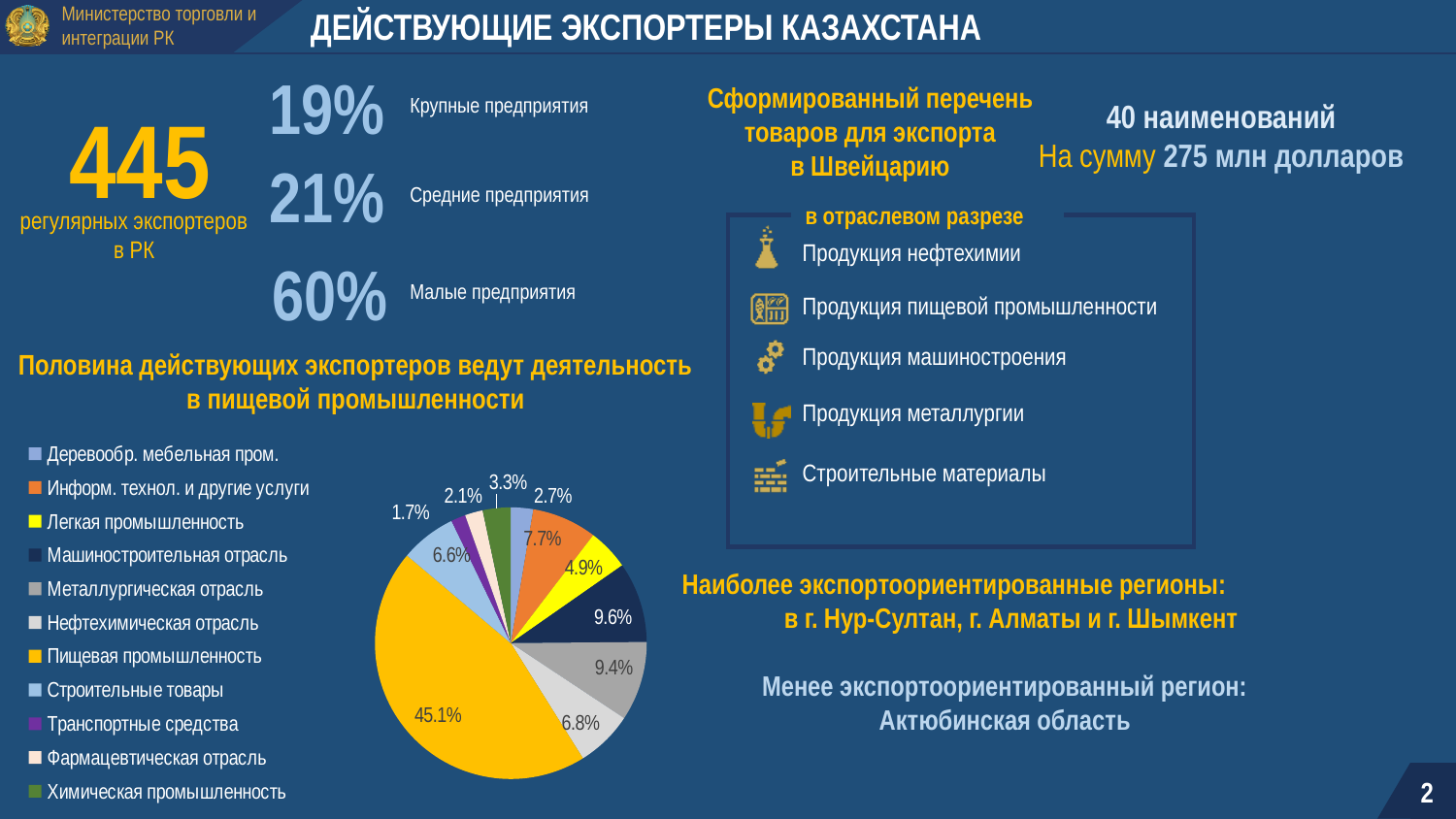
What is the value shown for Химическая промышленность? 3.3% What is the value shown for Машиностроительная отрасль? 9.6% Which category has the largest slice of the pie chart? Пищевая промышленность What kind of chart is shown on the slide? pie chart What is the value shown for Информ. технол. и другие услуги? 7.7% How many categories does the pie chart's legend list? 11 What is the value shown for Нефтехимическая отрасль? 6.8% Which is larger, the share of Строительные товары or the share of Легкая промышленность? Строительные товары Which colour represents Пищевая промышленность in the pie chart? gold/yellow-orange What share of the pie does Пищевая промышленность hold? 45.1% What is the difference between the shares of Пищевая промышленность and Нефтехимическая отрасль? 38.3 percentage points Which category has the smallest slice of the pie chart? Транспортные средства